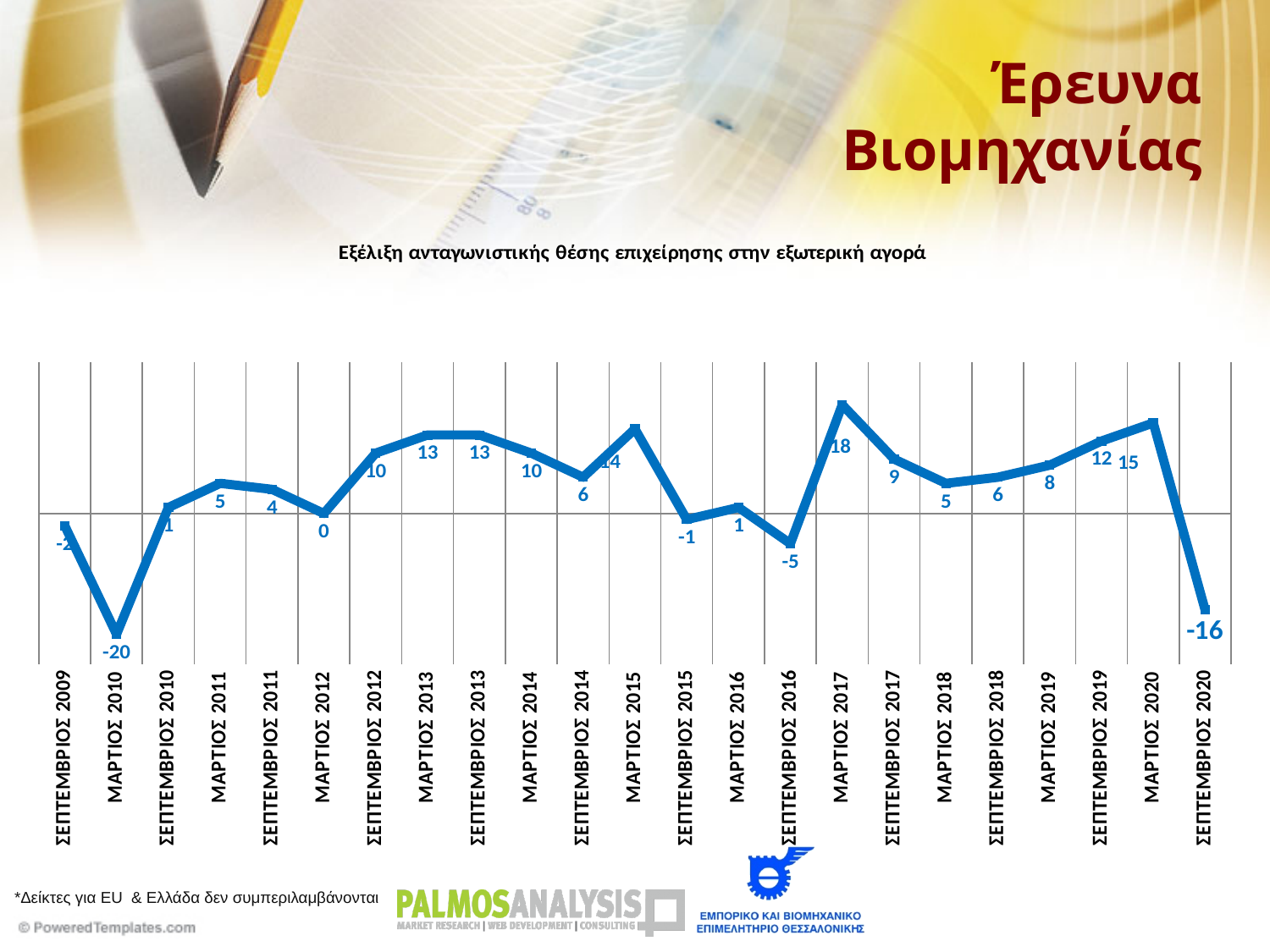
Which period has the highest value? ΜΑΡΤΙΟΣ 2017 What is the difference between the values for ΜΑΡΤΙΟΣ 2017 and ΣΕΠΤΕΜΒΡΙΟΣ 2017? 9 What kind of chart is shown? Line chart What is the title of the chart? Εξέλιξη ανταγωνιστικής θέσης επιχείρησης στην εξωτερική αγορά How many periods are plotted on the x axis? 23 Which is larger, the value for ΜΑΡΤΙΟΣ 2013 or the value for ΣΕΠΤΕΜΒΡΙΟΣ 2014? ΜΑΡΤΙΟΣ 2013 What is the value for ΜΑΡΤΙΟΣ 2017? 18 What is the value for ΜΑΡΤΙΟΣ 2012? 0 What is the value for ΣΕΠΤΕΜΒΡΙΟΣ 2020? -16 What is the value for ΣΕΠΤΕΜΒΡΙΟΣ 2016? -5 What is the difference between the values for ΜΑΡΤΙΟΣ 2020 and ΣΕΠΤΕΜΒΡΙΟΣ 2020? 31 Which period has the lowest value? ΜΑΡΤΙΟΣ 2010